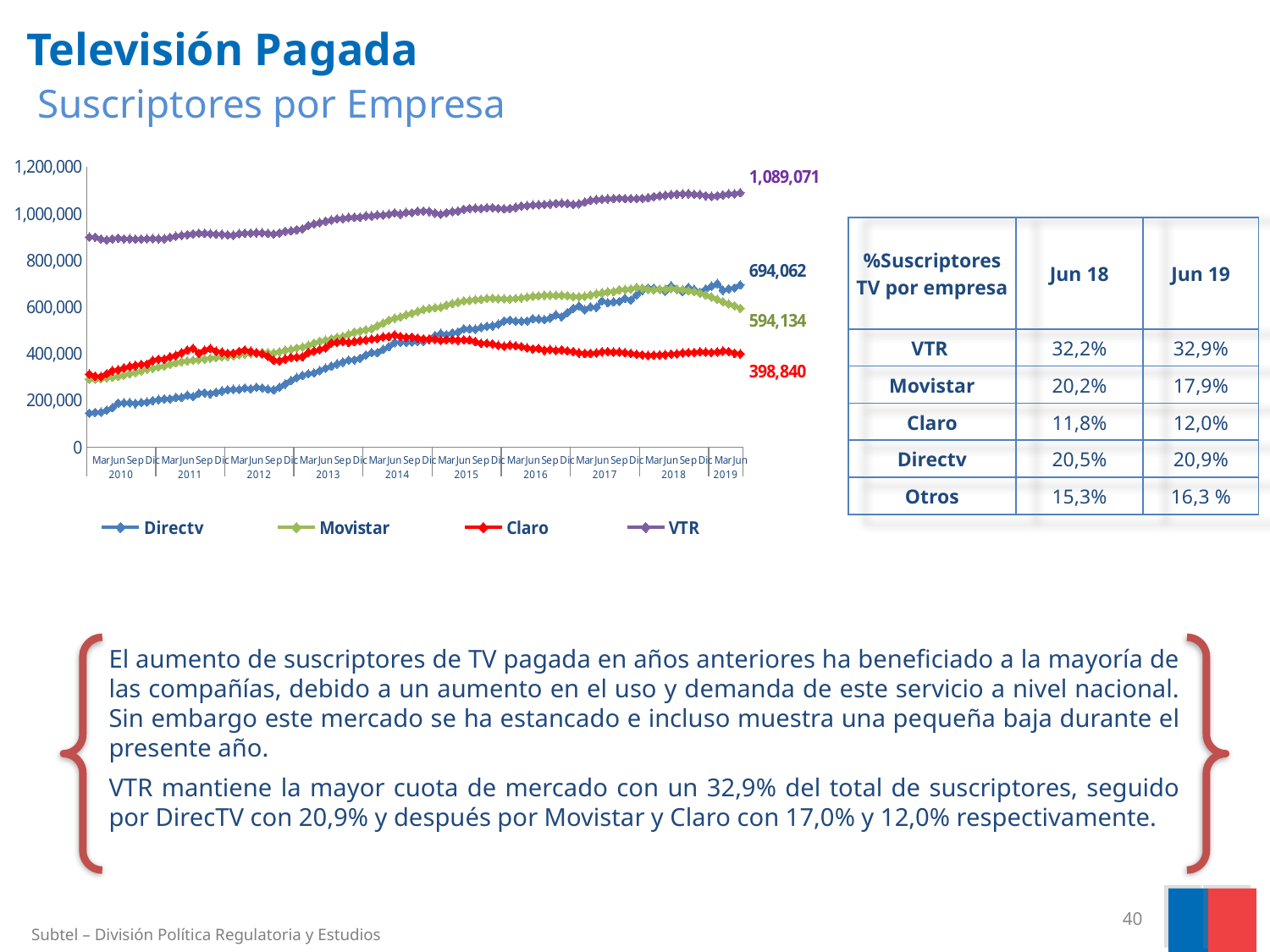
What is the final labelled value for Movistar on the chart? 594,134 Does the Directv series generally rise or fall from 2010 to 2019? rise How many series does the chart legend list? 4 Is the value for VTR at the start of the chart (Mar 2010) greater or less than 800,000? greater What is the difference between the final labelled values of Directv and Movistar? 99,928 Which series has the highest value at the end of the chart (Jun 2019)? VTR What is the final labelled value for VTR on the chart? 1,089,071 At the end of the chart, which is larger: the value for Movistar or the value for Claro? Movistar What type of chart is shown on the slide? line chart What is the final labelled value for Directv on the chart? 694,062 What is the final labelled value for Claro on the chart? 398,840 Which series has the lowest value at the end of the chart (Jun 2019)? Claro